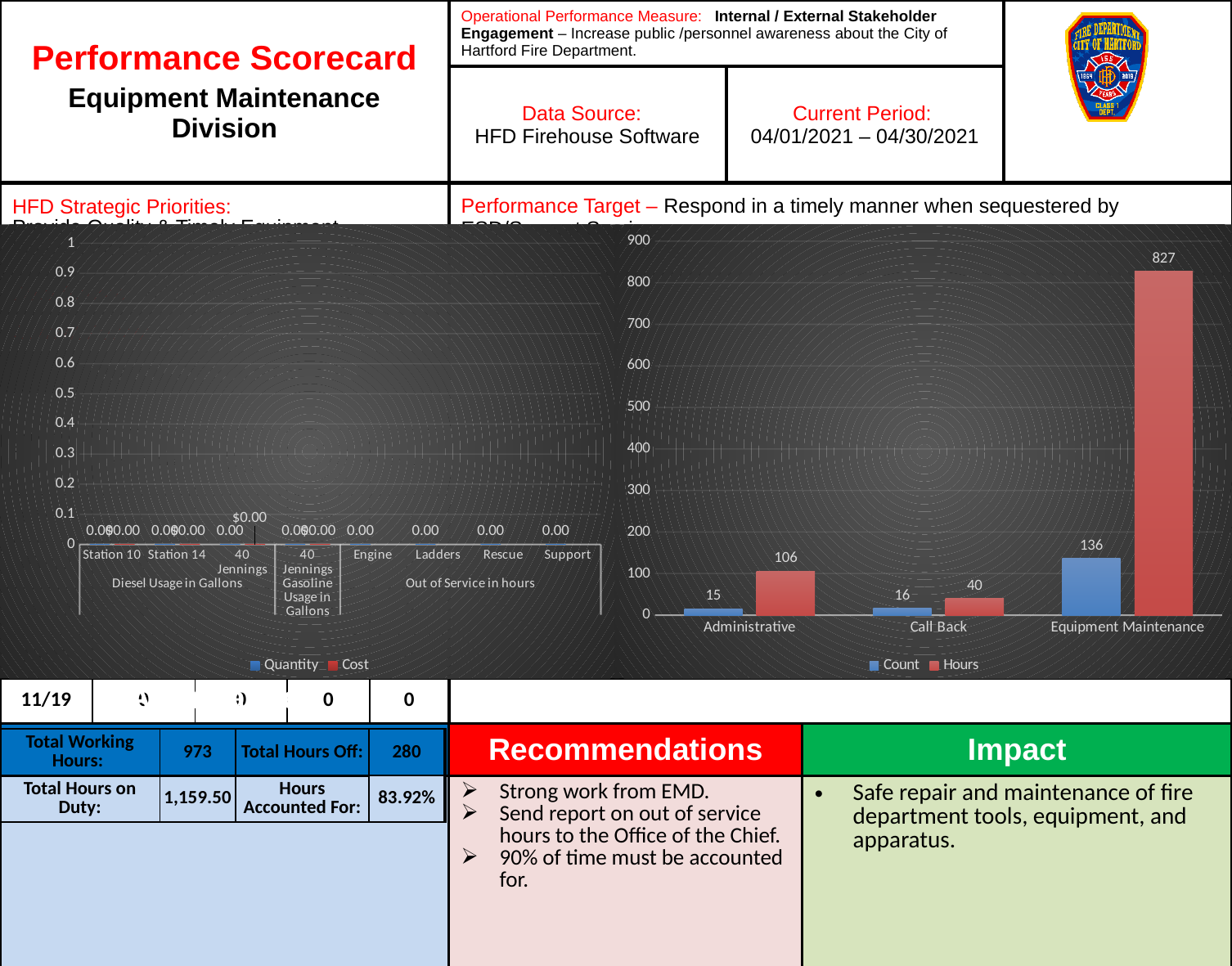
In the right-hand chart, which category has the lowest Count value? Administrative What type of chart is the right-hand chart? Bar chart In the right-hand chart, what is the difference between the Hours values for Administrative and Call Back? 66 How many series does the legend of the right-hand chart list? 2 In the right-hand chart, what is the Count value for Equipment Maintenance? 136 In the right-hand chart, what is the Count value for Administrative? 15 In the right-hand chart, what is the Hours value for Call Back? 40 In the right-hand chart, what is the Hours value for Equipment Maintenance? 827 In the right-hand chart, which is larger: the Hours value for Administrative or the Hours value for Call Back? Administrative In the right-hand chart, is the Hours value for Equipment Maintenance greater or less than 800? greater How many categories are shown on the x axis of the right-hand chart? 3 In the right-hand chart, which category has the highest Hours value? Equipment Maintenance